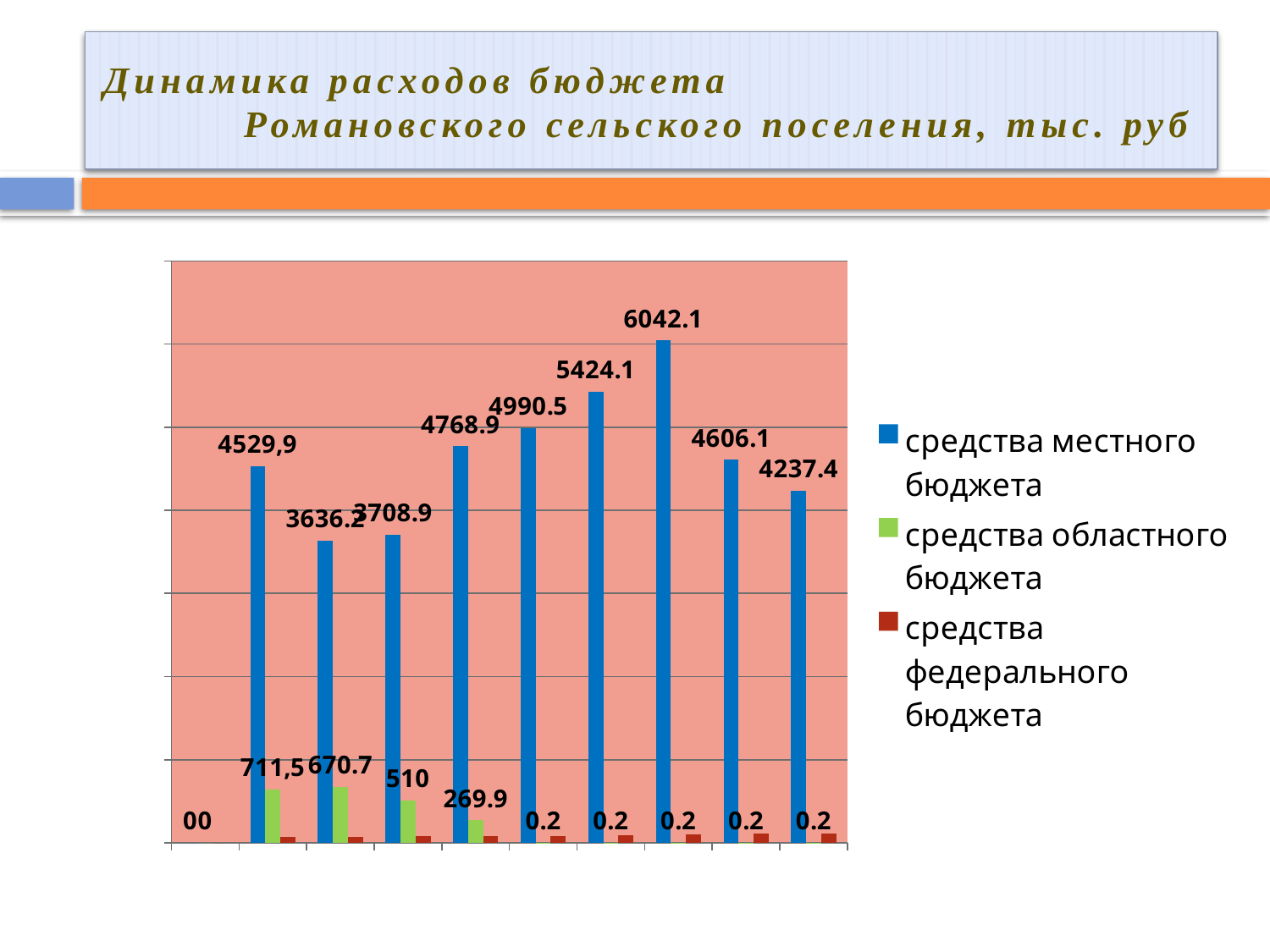
What is the value of 'средства местного бюджета' for the last (rightmost) group of bars? 4237.4 What is the highest value labelled for the 'средства местного бюджета' series? 6042.1 What is the value of 'средства областного бюджета' for the third group of bars from the left? 510 Which series is shown in blue according to the legend? средства местного бюджета What is the value of 'средства местного бюджета' for the first group of bars from the left? 4529,9 What is the lowest value labelled for the 'средства местного бюджета' series? 3636.2 Which is larger for 'средства местного бюджета': the eighth group (4606.1) or the ninth group (4237.4)? the eighth group (4606.1) Does the 'средства областного бюджета' series rise or fall from the first group to the fourth group? fall How many groups of bars are plotted along the x axis? 9 How many series does the legend list? 3 What is the difference between the 'средства местного бюджета' values of the seventh group (6042.1) and the sixth group (5424.1)? 618 What kind of chart is shown on the slide? bar chart